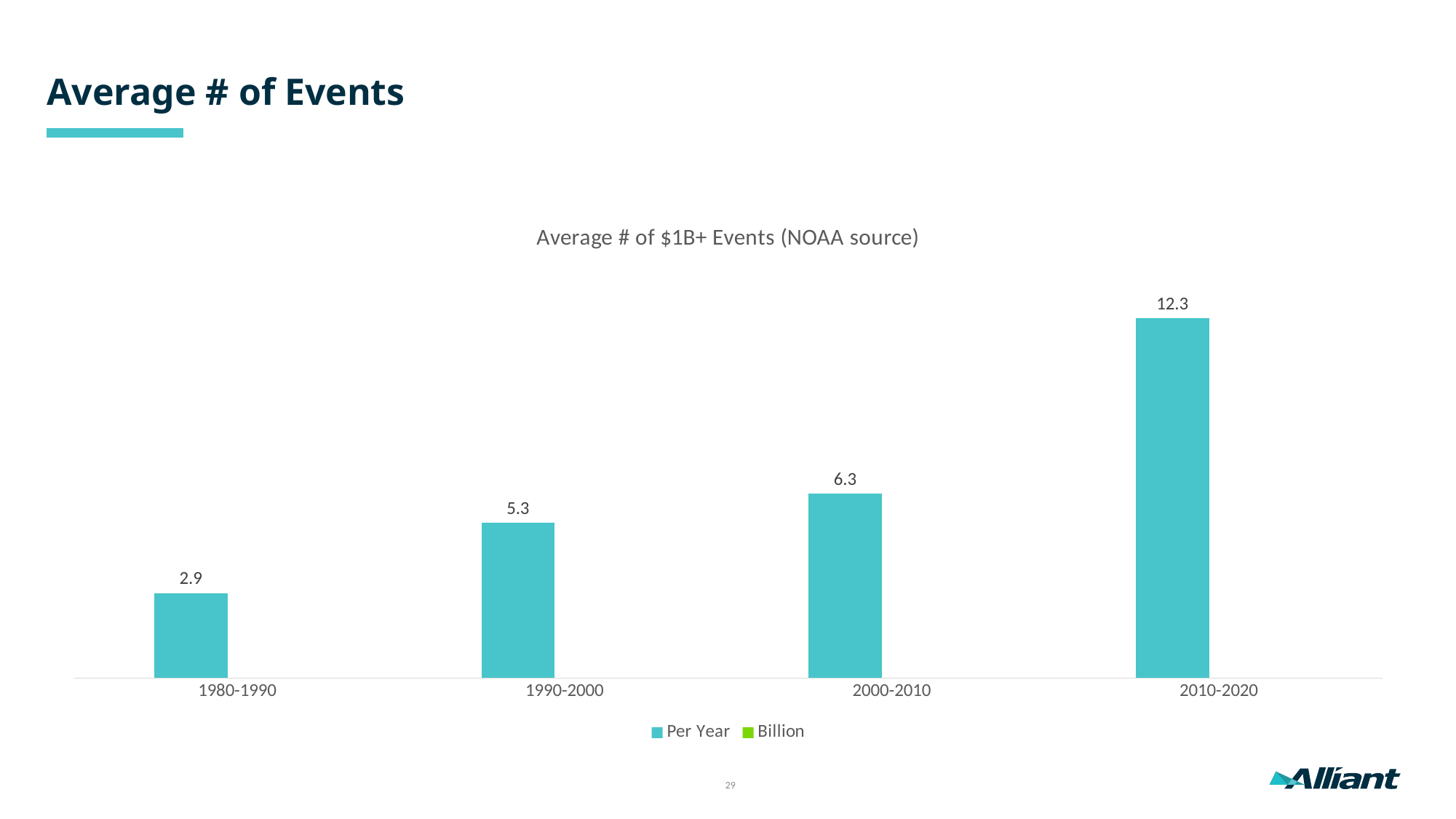
What is the difference between the Per Year values for 2010-2020 and 2000-2010? 6.0 Which period has the lowest average number of $1B+ events per year? 1980-1990 What is the Per Year value for 1980-1990? 2.9 What is the Per Year value for 2000-2010? 6.3 How many time periods are shown on the x axis? 4 What is the Per Year value for 2010-2020? 12.3 Which period has a larger Per Year value, 1990-2000 or 2000-2010? 2000-2010 What is the difference between the Per Year values for 1990-2000 and 1980-1990? 2.4 What is the Per Year value for 1990-2000? 5.3 Which period has the highest average number of $1B+ events per year? 2010-2020 How many series does the legend list? 2 Do the Per Year values rise or fall from 1980-1990 to 2010-2020? rise